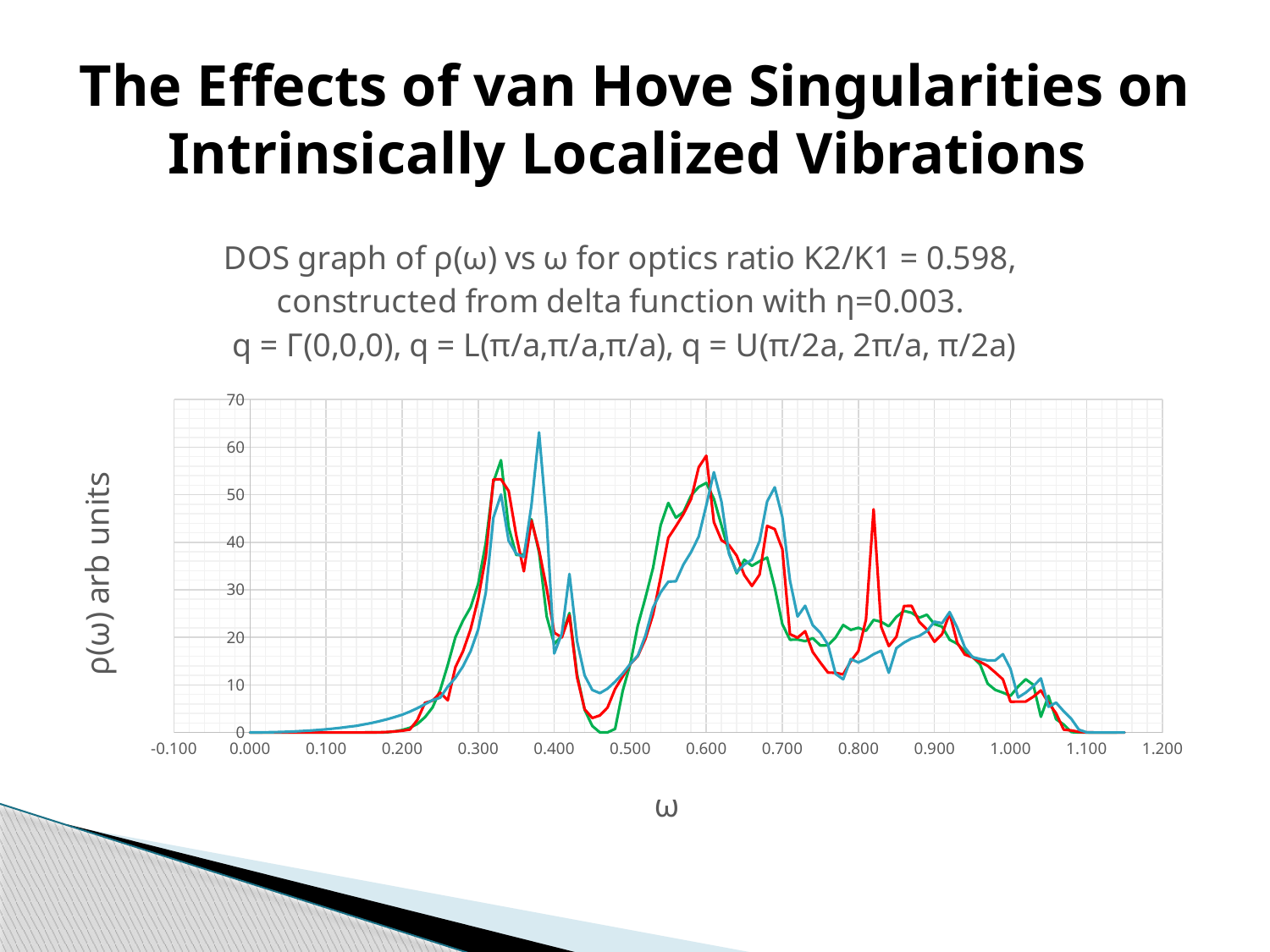
Is the peak value of the red line near ω = 0.600 greater or less than 50? greater Is the value of the blue line near ω = 0.780 greater or less than 20? less Do the plotted values rise or fall as ω increases from 1.000 to 1.100? Fall Which coloured line reaches the highest peak on the chart? Blue Do the plotted values rise or fall as ω increases from 0.200 to 0.320? Rise Is the value of the red line at its spike near ω = 0.820 greater or less than 40? greater What is the label of the x-axis of the chart? ω What is the label of the y-axis of the chart? ρ(ω) arb units How many lines are plotted on the chart? 3 What type of chart is shown on the slide? Line chart